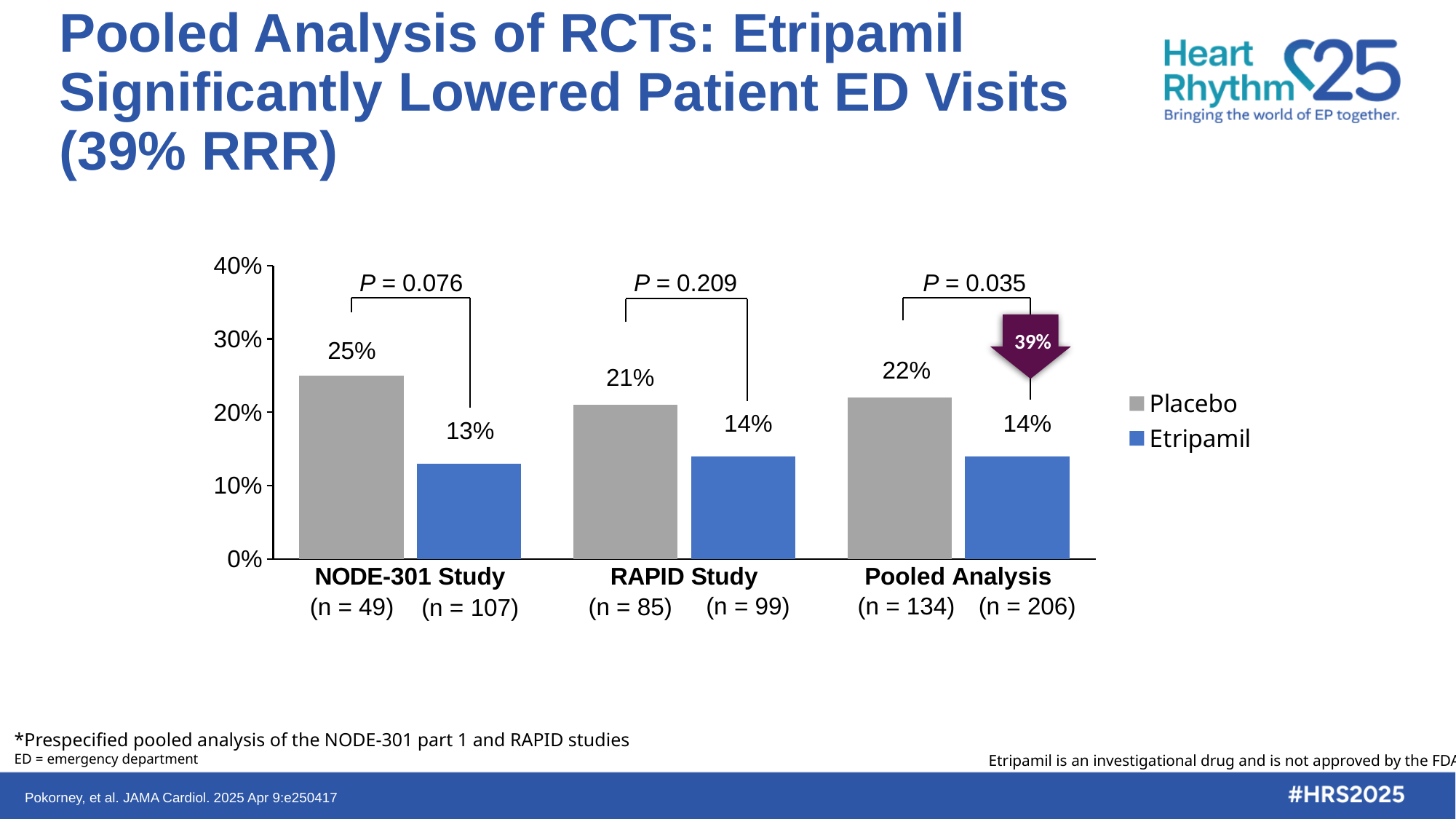
Which study group has the lowest Etripamil value? NODE-301 Study What is the Placebo value for the NODE-301 Study? 25% What is the Placebo value in the Pooled Analysis? 22% Which is larger in the RAPID Study, the Placebo value or the Etripamil value? Placebo Is the Placebo value for the NODE-301 Study greater or less than 20%? greater How many series does the legend list? 2 How many study groups are shown on the x axis? 3 What is the Etripamil value for the RAPID Study? 14% Which study group has the highest Placebo value? NODE-301 Study What is the difference between the Placebo and Etripamil values in the Pooled Analysis? 8% What is the difference between the Placebo and Etripamil values in the NODE-301 Study? 12% What kind of chart is shown on the slide? Bar chart